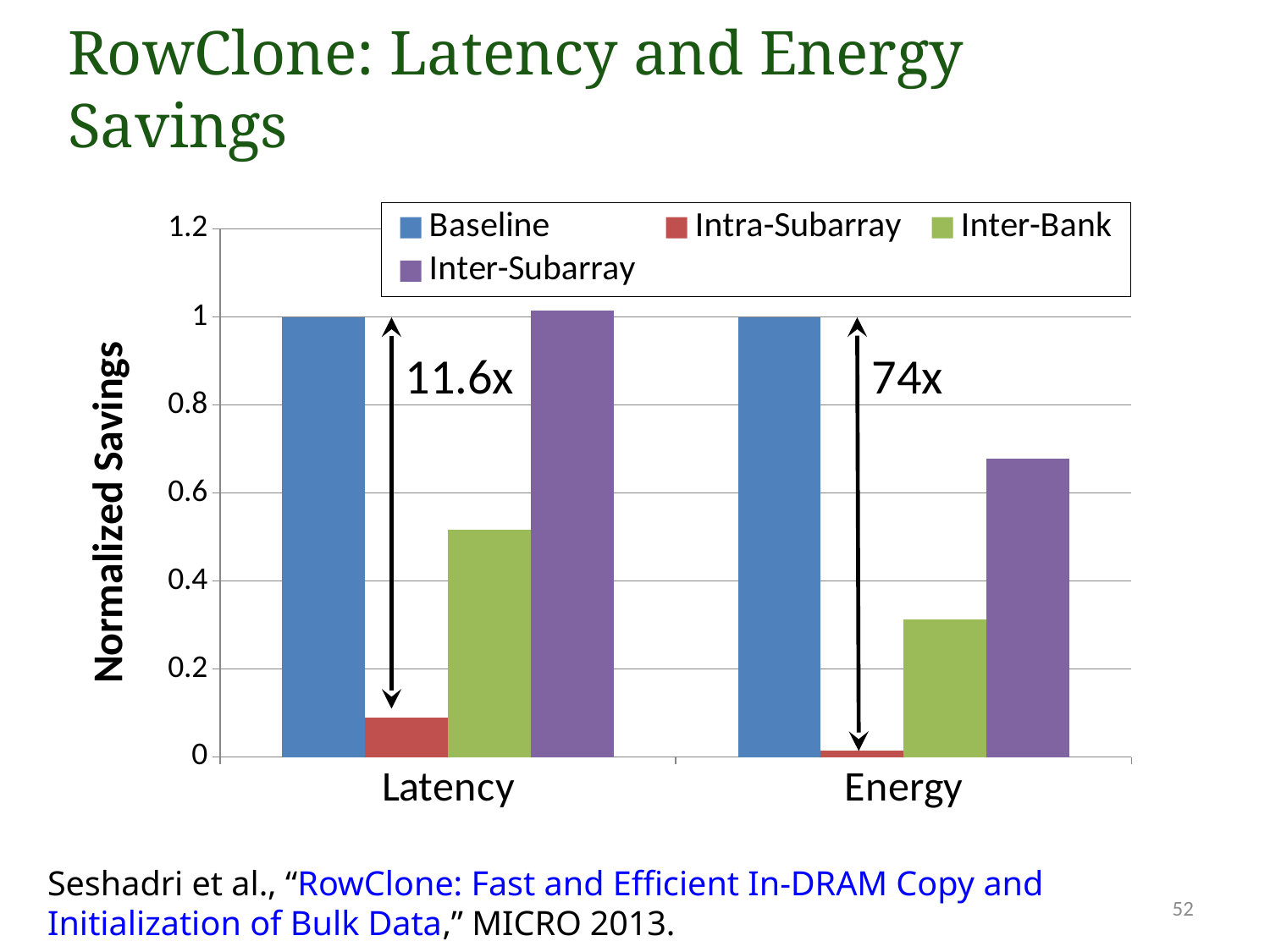
What is the Baseline value for Energy? 1 Is the Inter-Bank value for Latency greater or less than 0.4? greater What kind of chart is shown on the slide? bar chart How many categories are shown on the x axis? 2 Which series has the lowest value for Energy? Intra-Subarray Which is larger, the Inter-Subarray value for Latency or the Inter-Subarray value for Energy? Latency Which series has the lowest value for Latency? Intra-Subarray Is the Inter-Bank value for Energy greater or less than 0.4? less What improvement factor is annotated above the Energy group? 74x How many series does the legend list? 4 Which series has the highest value for Energy? Baseline What is the Baseline value for Latency? 1